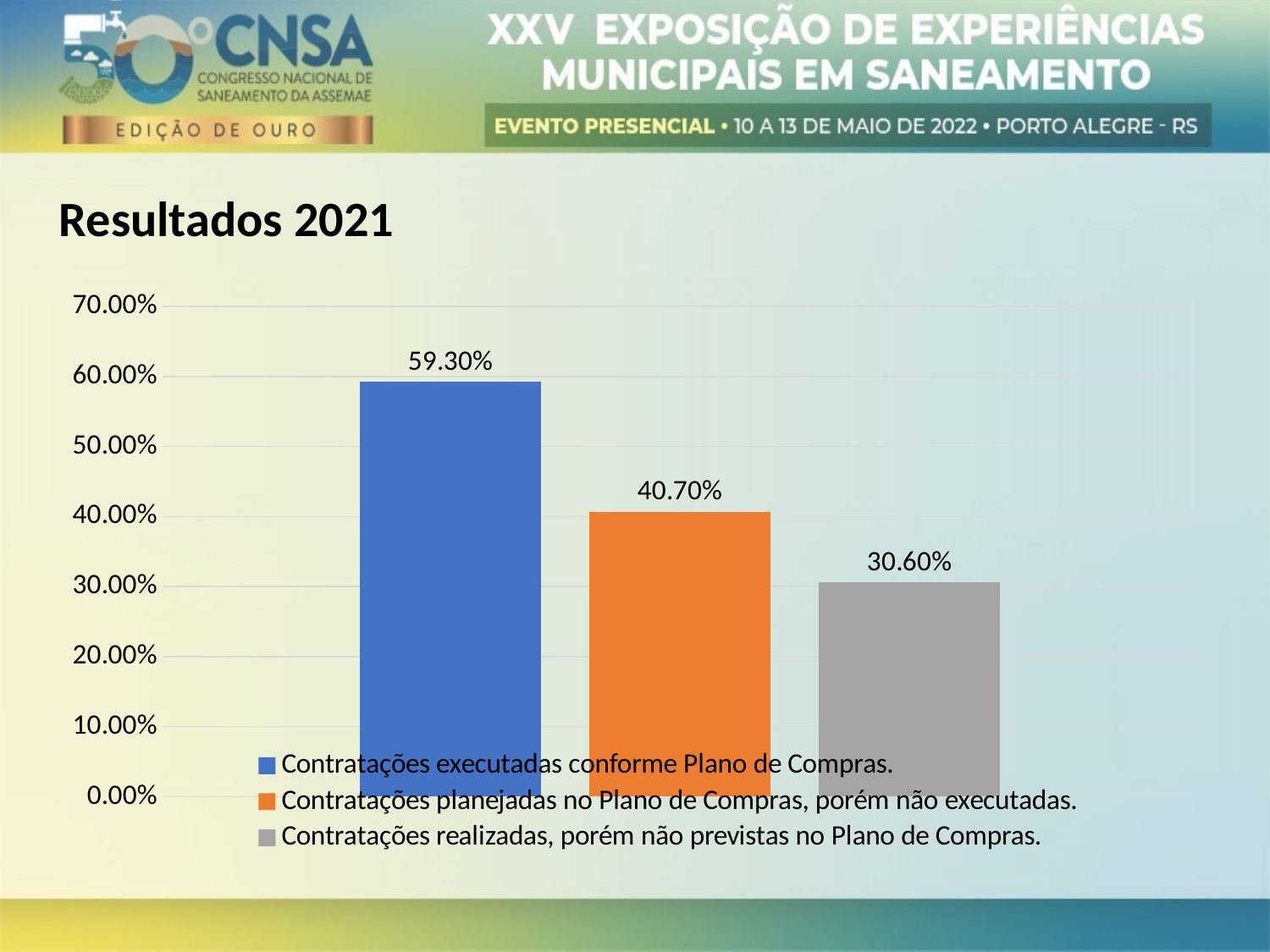
How many series does the legend list? 3 What is the value for 'Contratações executadas conforme Plano de Compras.'? 59.30% Which is larger: the value for 'Contratações executadas conforme Plano de Compras.' or the value for 'Contratações realizadas, porém não previstas no Plano de Compras.'? Contratações executadas conforme Plano de Compras. What is the difference between the values for 'Contratações planejadas no Plano de Compras, porém não executadas.' and 'Contratações realizadas, porém não previstas no Plano de Compras.'? 10.10% Is the value for 'Contratações planejadas no Plano de Compras, porém não executadas.' greater or less than 50.00%? less Which series has the highest value? Contratações executadas conforme Plano de Compras. What kind of chart is shown on the slide? bar chart Which series has the lowest value? Contratações realizadas, porém não previstas no Plano de Compras. What colour is the bar for 'Contratações planejadas no Plano de Compras, porém não executadas.'? orange What is the value for 'Contratações realizadas, porém não previstas no Plano de Compras.'? 30.60% What is the value for 'Contratações planejadas no Plano de Compras, porém não executadas.'? 40.70% What is the difference between the values for 'Contratações executadas conforme Plano de Compras.' and 'Contratações planejadas no Plano de Compras, porém não executadas.'? 18.60%